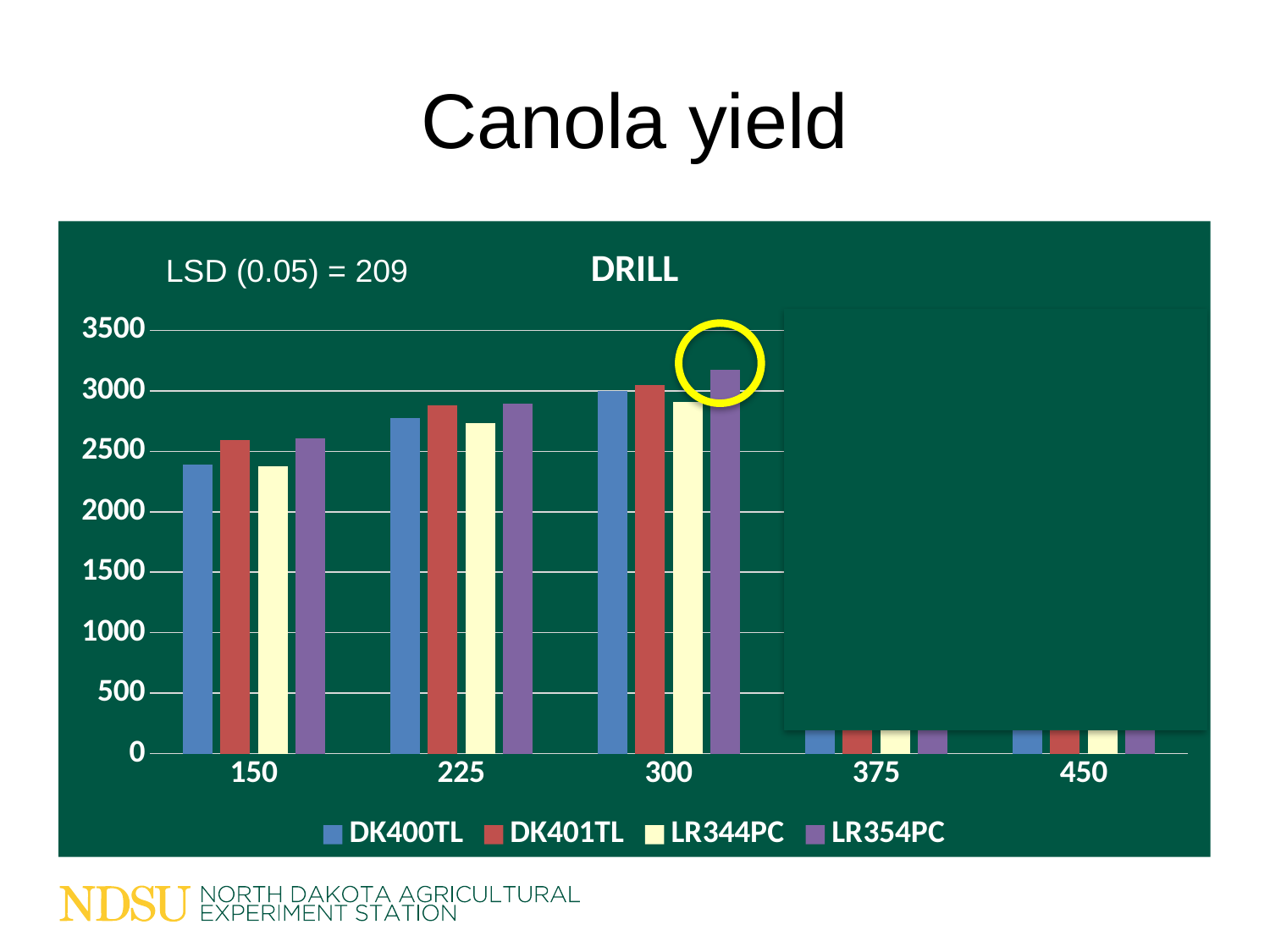
Is the value for DK401TL at 225 greater or less than 2500? greater How many series does the legend list? 4 Is the value for DK400TL at 150 greater or less than 2500? less At 150, which is larger: DK400TL or DK401TL? DK401TL What kind of chart is shown on the slide? bar chart Is the value for LR354PC at 225 greater or less than 3000? less What LSD (0.05) value is printed on the chart? 209 Do the DK400TL values rise or fall from 150 to 300? rise How many categories are labelled on the x axis? 5 At 300, which series has the highest bar? LR354PC What is the title shown above the chart? DRILL